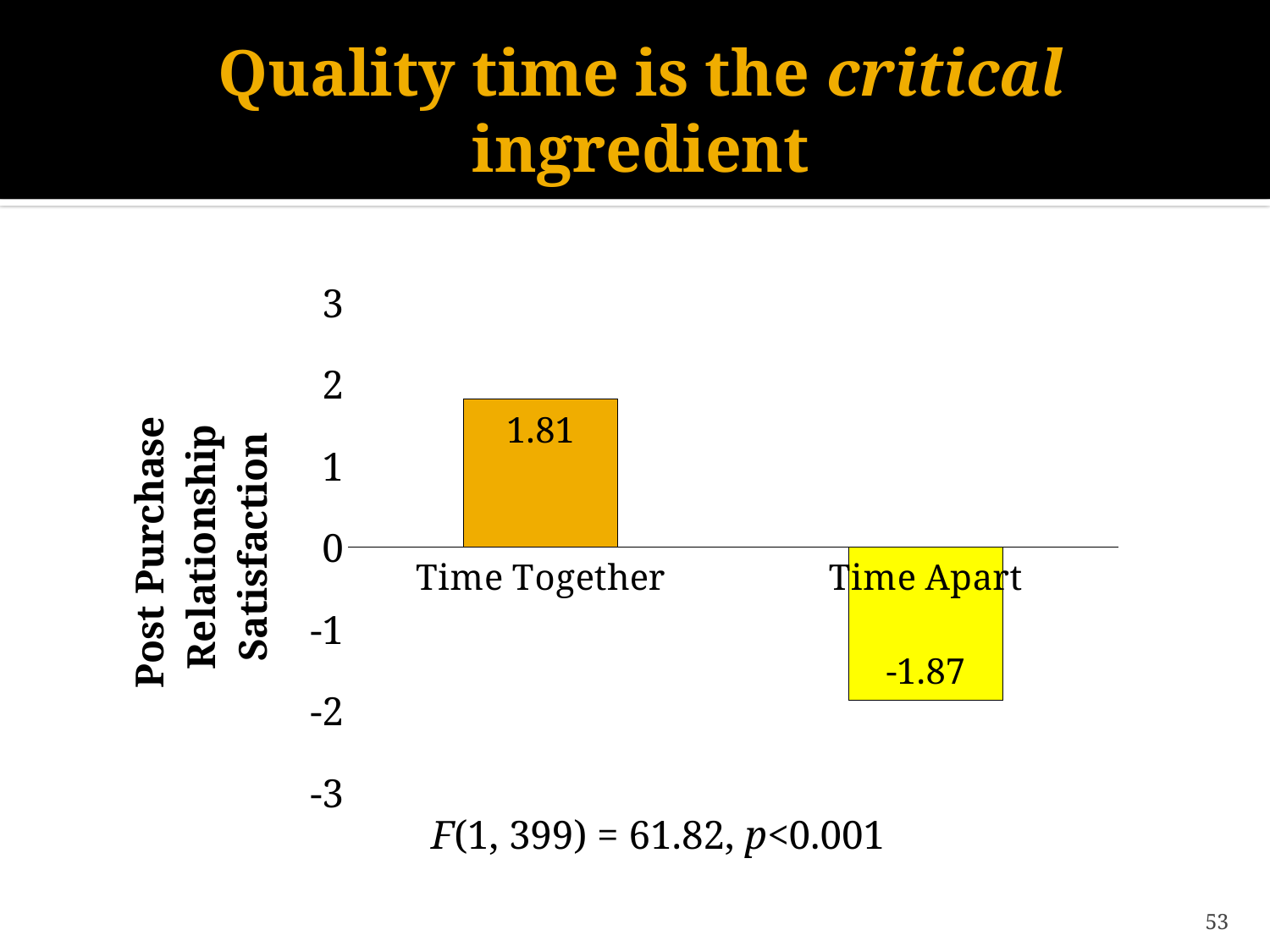
Is the value for Time Together greater or less than 1? greater What kind of chart is shown on the slide? bar chart How many categories are shown on the x axis? 2 What is the difference between the values for Time Together and Time Apart? 3.68 What is the value for Time Apart? -1.87 Is the value for Time Apart greater or less than -1? less What is the label of the vertical axis? Post Purchase Relationship Satisfaction Which category has the highest value? Time Together Which category has the lowest value? Time Apart Which is larger, the value for Time Together or the value for Time Apart? Time Together What colour is the bar for Time Apart? yellow What is the value for Time Together? 1.81